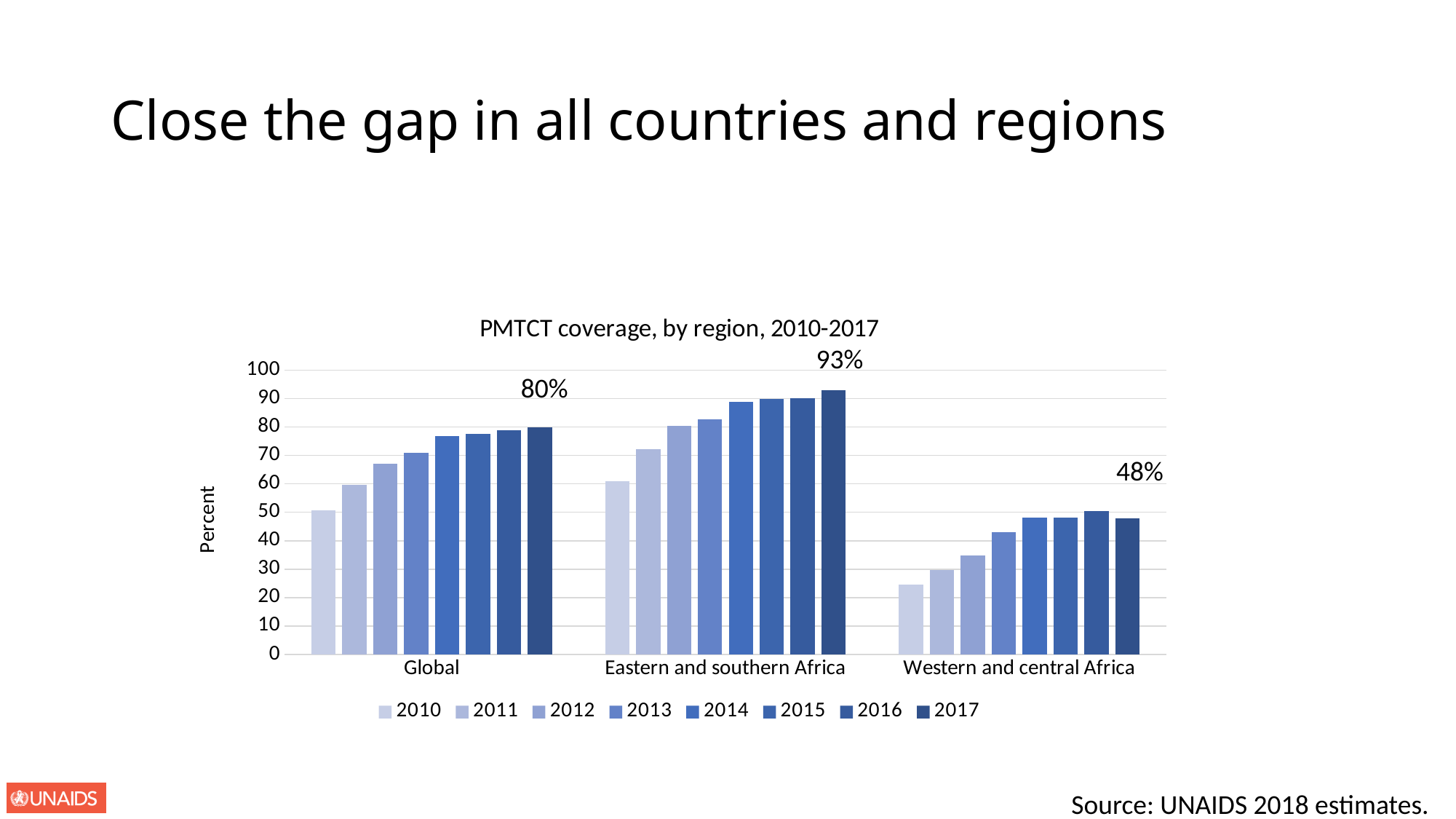
What is the difference between the 2017 labelled values for Eastern and southern Africa and Western and central Africa? 45 percentage points Which region has the lowest PMTCT coverage in 2017? Western and central Africa How many regions are shown on the x axis of the chart? 3 Is the value for Western and central Africa in 2010 greater or less than 30? less What kind of chart is shown on the slide? Bar chart Is the 2017 value larger for Global or for Western and central Africa? Global What is the PMTCT coverage value labelled for Western and central Africa in 2017? 48% How many series (years) does the legend list? 8 What is the PMTCT coverage value labelled for Global in 2017? 80% Is the value for Global in 2010 greater or less than 60? less What is the PMTCT coverage value labelled for Eastern and southern Africa in 2017? 93% Which region has the highest PMTCT coverage in 2017? Eastern and southern Africa